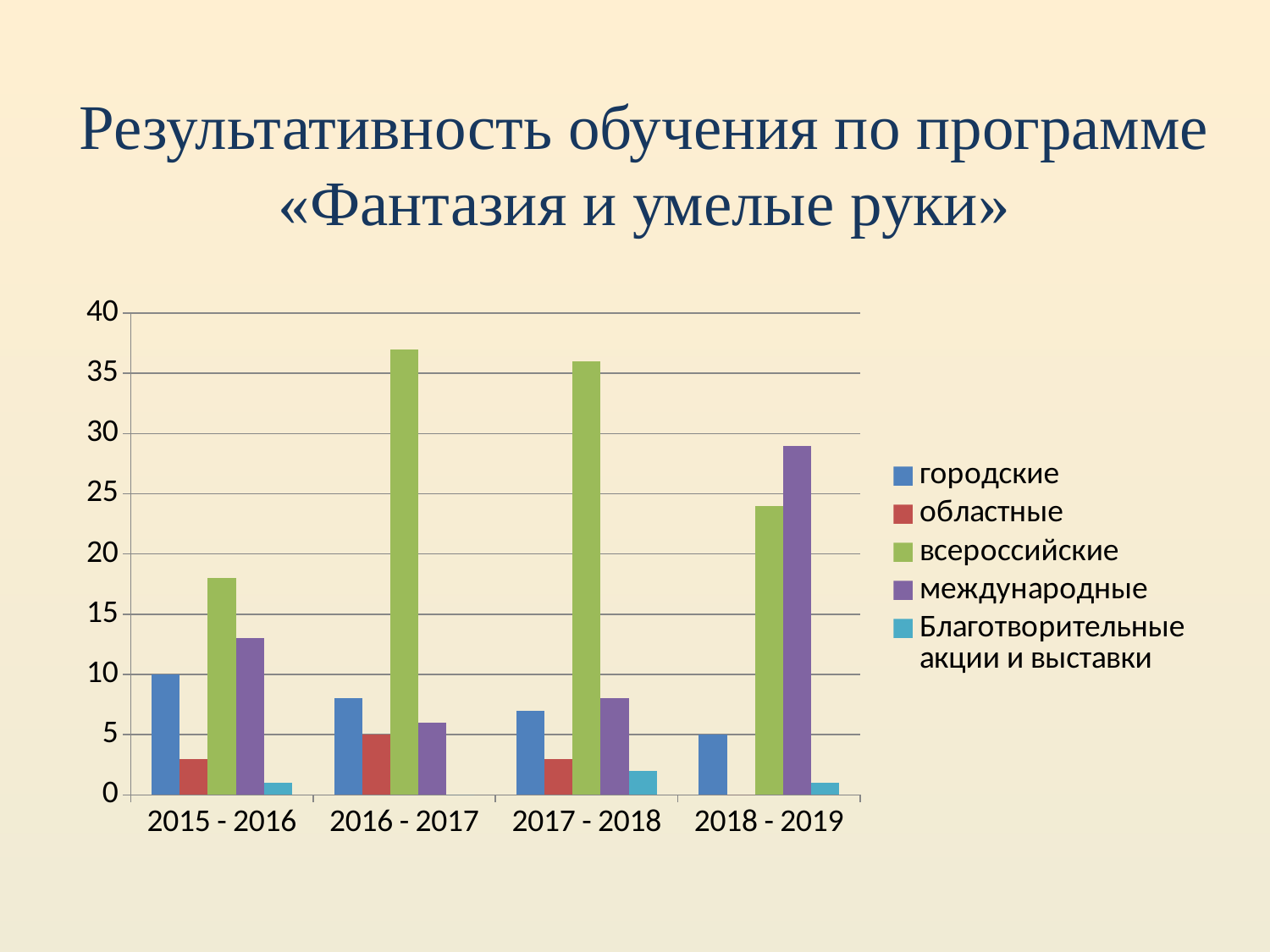
How many academic-year categories are shown on the x axis? 4 Is the value for всероссийские in 2015 - 2016 greater or less than 15? greater What is the value for городские in 2015 - 2016? 10 Which series has the lowest value in 2015 - 2016? Благотворительные акции и выставки How many series does the legend list? 5 Is the value for международные in 2018 - 2019 greater or less than 25? greater What is the value for городские in 2018 - 2019? 5 Which series has the highest value in 2018 - 2019? международные What is the value for областные in 2016 - 2017? 5 Is the value for всероссийские in 2016 - 2017 greater or less than 35? greater Do the values for городские rise or fall from 2015 - 2016 to 2018 - 2019? fall What type of chart is shown on the slide? bar chart